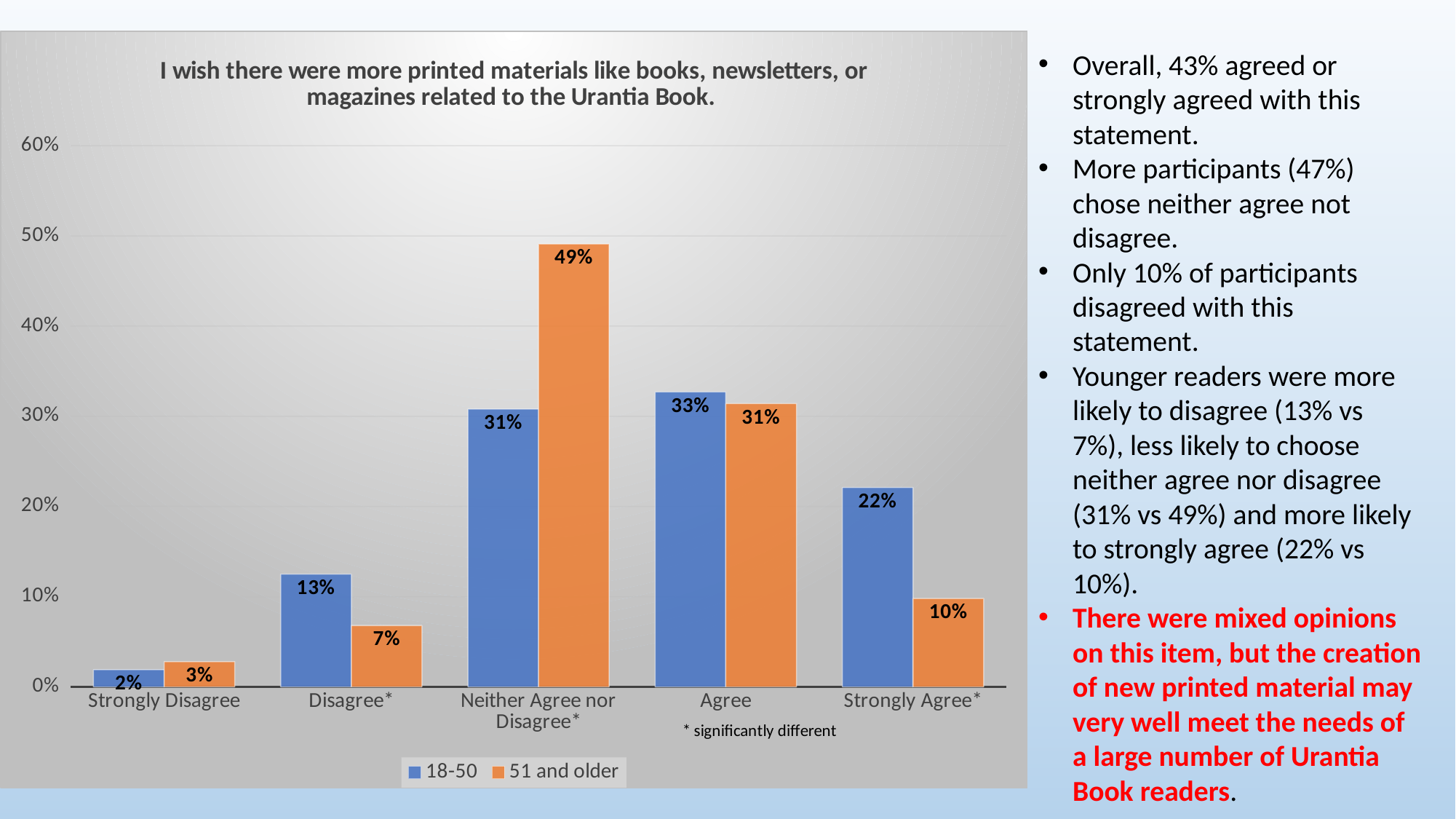
What is the value for the 51 and older series in the Disagree category? 7% What is the value for the 51 and older series in the Strongly Agree category? 10% What is the difference between the 51 and older and 18-50 values in the Neither Agree nor Disagree category? 18% In the Strongly Agree category, which series has the larger value, 18-50 or 51 and older? 18-50 How many series does the legend list? 2 Which category has the lowest value for the 18-50 series? Strongly Disagree Which category has the highest value for the 51 and older series? Neither Agree nor Disagree How many categories are shown on the x axis? 5 Which colour represents the 51 and older series? Orange Is the value for the 51 and older series in the Neither Agree nor Disagree category greater or less than 40%? greater What is the value for the 18-50 series in the Neither Agree nor Disagree category? 31% What kind of chart is shown on the slide? Bar chart